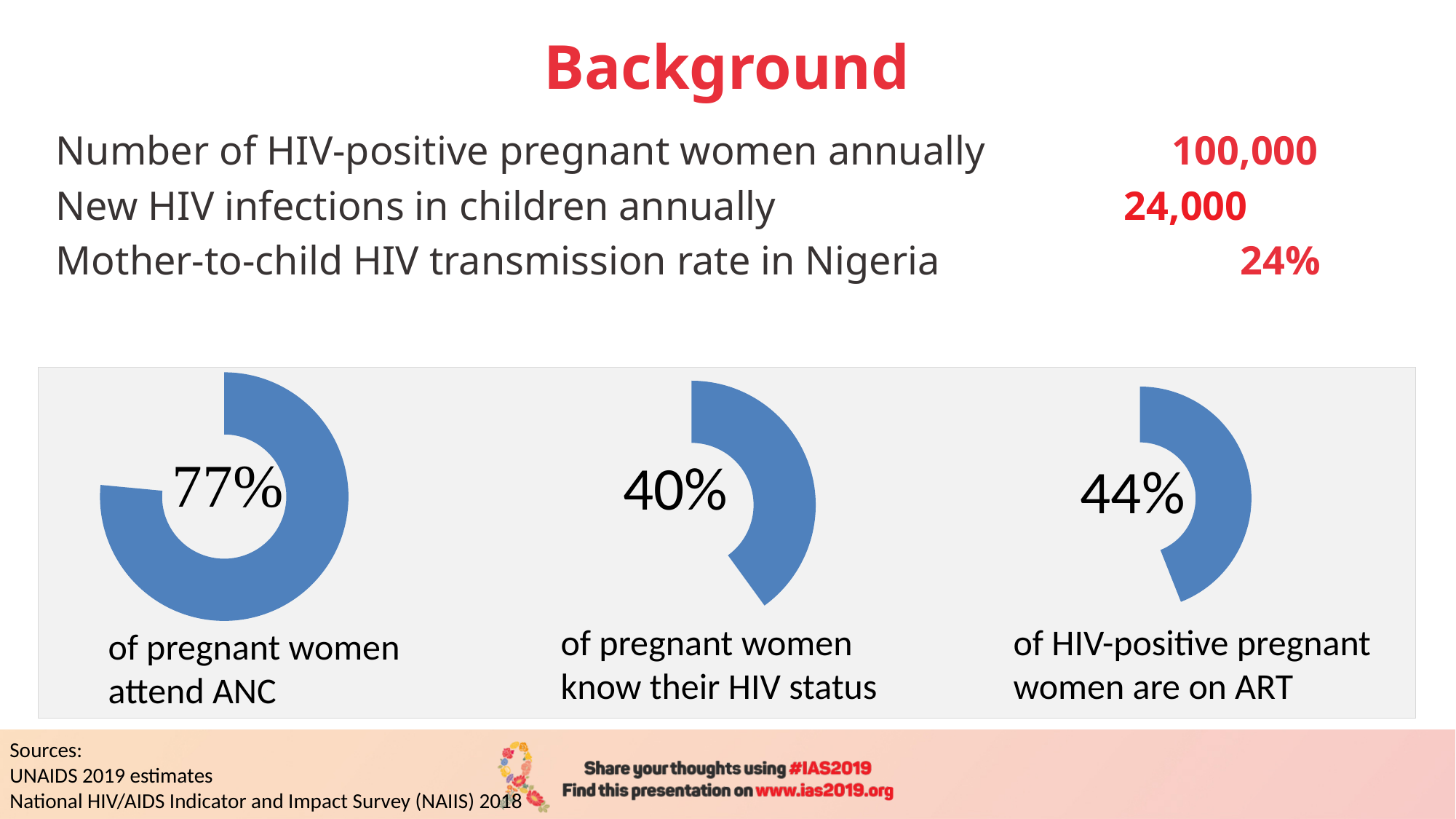
Which is larger: the percentage of HIV-positive pregnant women on ART or the percentage of pregnant women who know their HIV status? HIV-positive pregnant women on ART (44%) How many ring charts are shown on the slide? 3 What percentage of pregnant women know their HIV status, according to the middle chart? 40% What kind of chart is used to display the three percentages on the slide? Ring (donut) chart What percentage of HIV-positive pregnant women are on ART, according to the right chart? 44% Which of the three ring charts shows the highest percentage? Pregnant women attending ANC (77%) What colour are the filled portions of the three ring charts? Blue What is the difference between the percentage of pregnant women attending ANC and the percentage who know their HIV status? 37 percentage points What percentage of pregnant women attend ANC, according to the left chart? 77% Which of the three ring charts shows the lowest percentage? Pregnant women who know their HIV status (40%) Is the percentage of pregnant women attending ANC greater or less than 50%? greater What is the difference between the percentage of HIV-positive pregnant women on ART and the percentage of pregnant women who know their HIV status? 4 percentage points